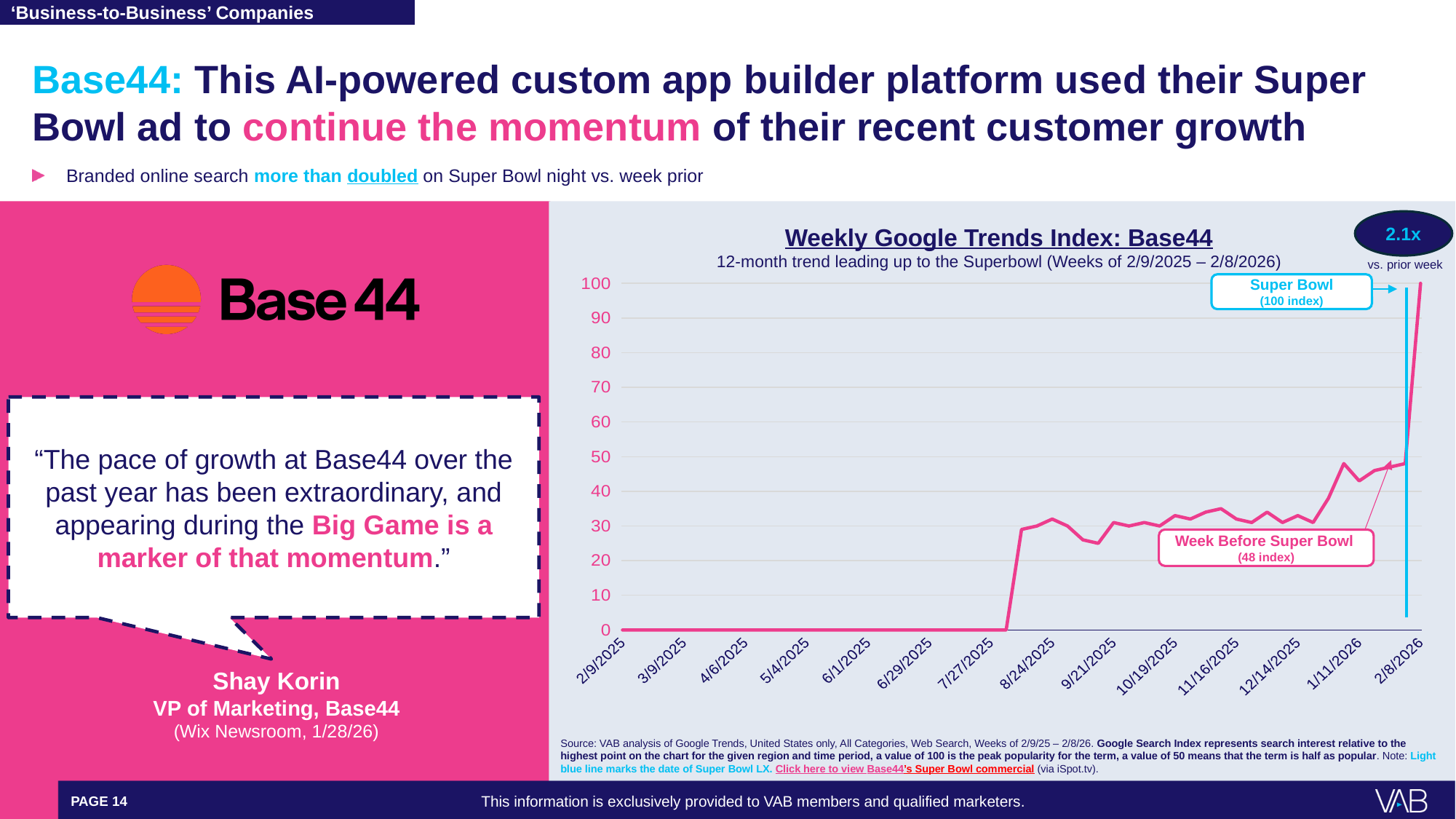
Does the index rise or fall between 7/27/2025 and 8/24/2025? rise What is the Google Trends index value for the week before the Super Bowl? 48 index Is the value for 9/21/2025 greater or less than 20? greater What is the Google Trends index value for the Super Bowl week? 100 index Which is larger, the index value at 8/24/2025 or at 1/11/2026? 1/11/2026 Is the value for 11/16/2025 greater or less than 50? less Which week has the highest Google Trends index value on the chart? 2/8/2026 (Super Bowl week) What kind of chart is shown on the slide? line chart What is the difference between the Super Bowl week index and the week-before index? 52 Is the value for 3/9/2025 greater or less than 10? less How many date labels are shown on the x axis? 14 What is the title of the chart? Weekly Google Trends Index: Base44